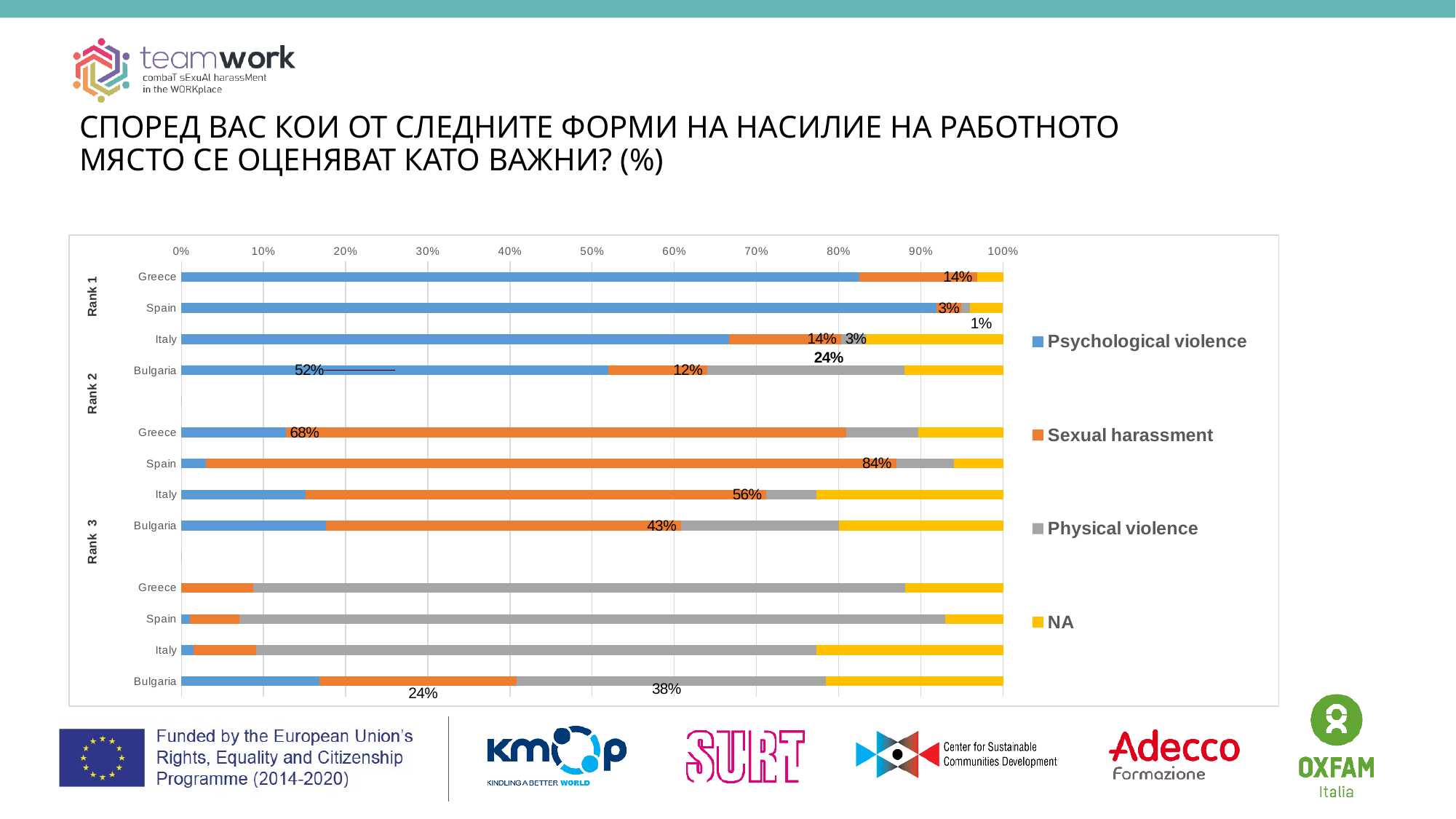
Which series are listed in the legend? Psychological violence, Sexual harassment, Physical violence, NA What is the Psychological violence value for Bulgaria in Rank 1? 52% What is the Sexual harassment value for Greece in Rank 1? 14% What is the Physical violence value for Bulgaria in Rank 3? 38% Among the Rank 2 bars, which country has the highest labelled Sexual harassment value? Spain How many series does the legend list? 4 What is the Sexual harassment value for Spain in Rank 2? 84% Is the Psychological violence value for Italy in Rank 1 greater or less than 60%? greater Among the Rank 2 bars, which country has the lowest labelled Sexual harassment value? Bulgaria What kind of chart is shown on the slide? Stacked bar chart What is the difference between the Rank 2 Sexual harassment values for Spain and Bulgaria? 41 percentage points How many bars are plotted in the chart? 12